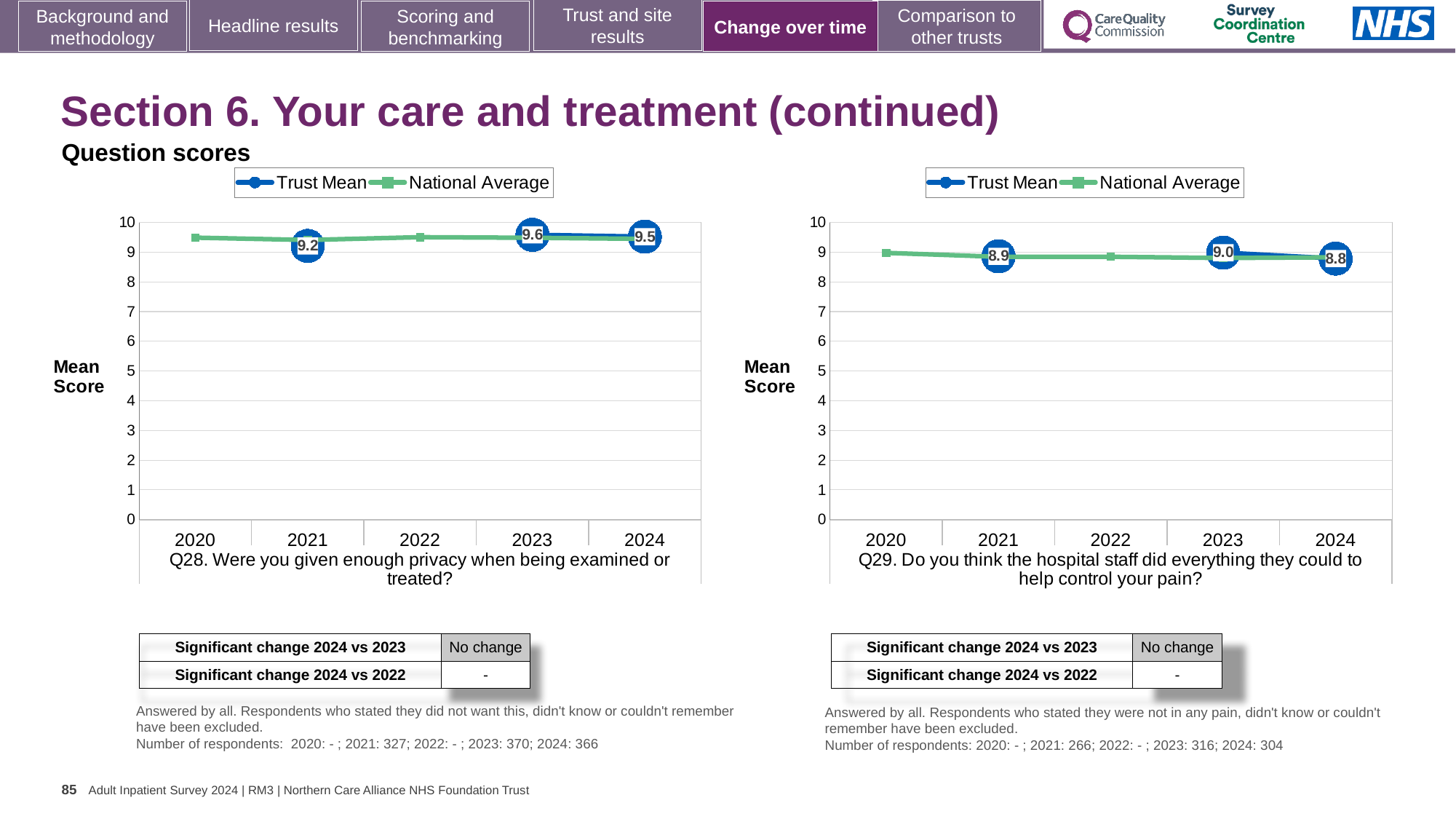
In the Q28 chart (left), what is the difference between the Trust Mean scores for 2023 and 2021? 0.4 What is the y-axis label on the Q28 chart (left)? Mean Score In the Q28 chart (left), what is the Trust Mean score for 2023? 9.6 In the Q28 chart (left), is the National Average value for 2020 greater or less than 9? greater In the Q28 chart (left), what is the Trust Mean score for 2021? 9.2 In the Q29 chart (right), is the Trust Mean score higher in 2023 or in 2024? 2023 What type of chart is used for Q29 (right)? Line chart In the Q28 chart (left), which year has the lowest labelled Trust Mean score? 2021 How many series does the legend of the Q28 chart (left) list? 2 In the Q29 chart (right), what is the Trust Mean score for 2024? 8.8 In the Q29 chart (right), which year has the highest labelled Trust Mean score? 2023 How many years are shown on the x axis of the Q29 chart (right)? 5